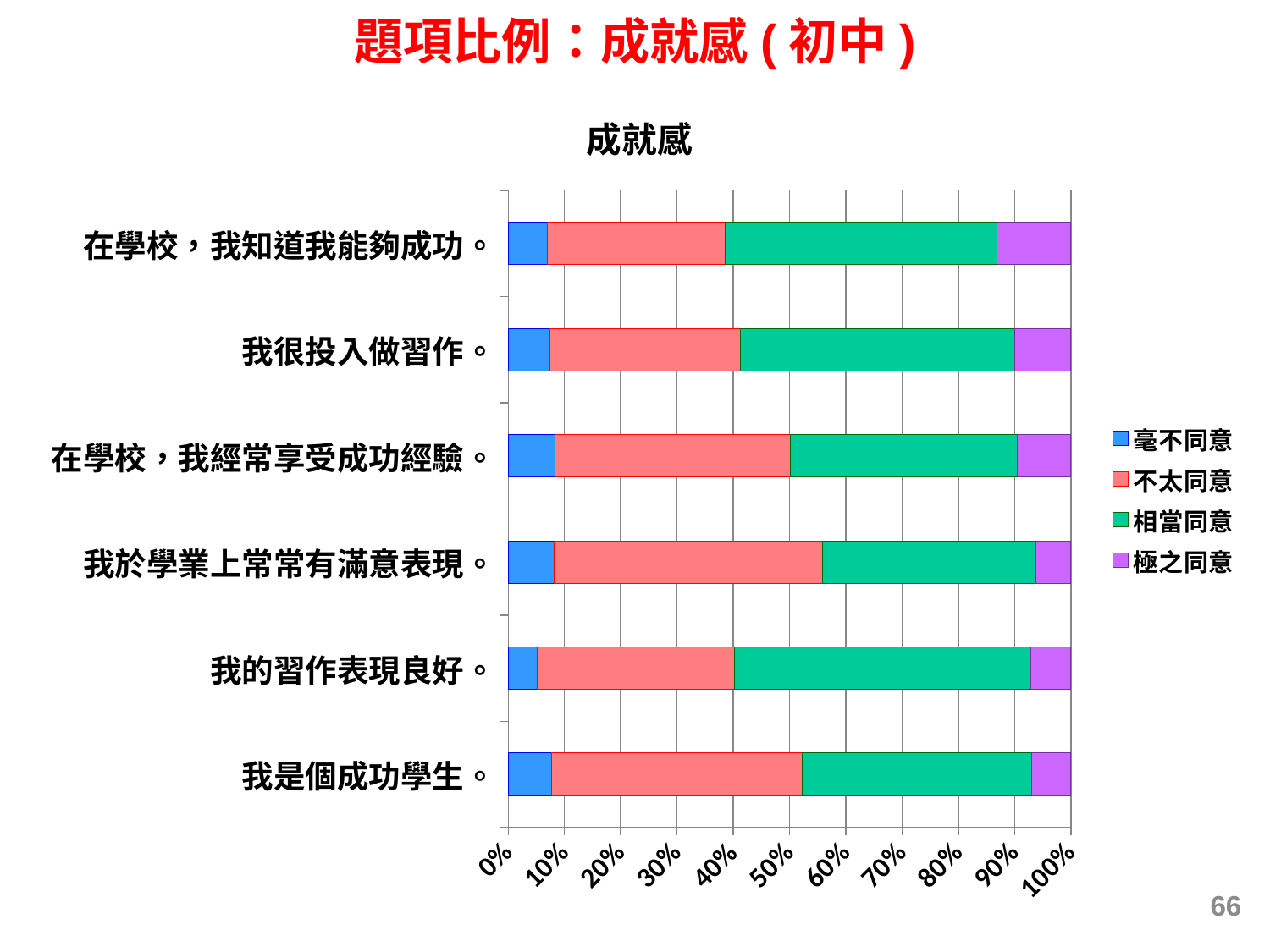
Which statement has the smallest 毫不同意 segment? 我的習作表現良好。 Is the 毫不同意 segment for 我的習作表現良好 greater or less than 10%? less Which statement has the largest 極之同意 segment? 在學校，我知道我能夠成功。 What do the four segments of each bar add up to? 100% How many series does the legend list? 4 How many statements (categories) are plotted on the chart? 6 Which legend entry is shown in green? 相當同意 Which has the larger 極之同意 segment: 在學校，我知道我能夠成功 or 我於學業上常常有滿意表現? 在學校，我知道我能夠成功。 What is the title of the chart? 成就感 Is the 不太同意 segment for 我於學業上常常有滿意表現 greater or less than 40%? greater What kind of chart is shown on the slide? Stacked bar chart Is the 相當同意 segment for 在學校，我知道我能夠成功 greater or less than 40%? greater